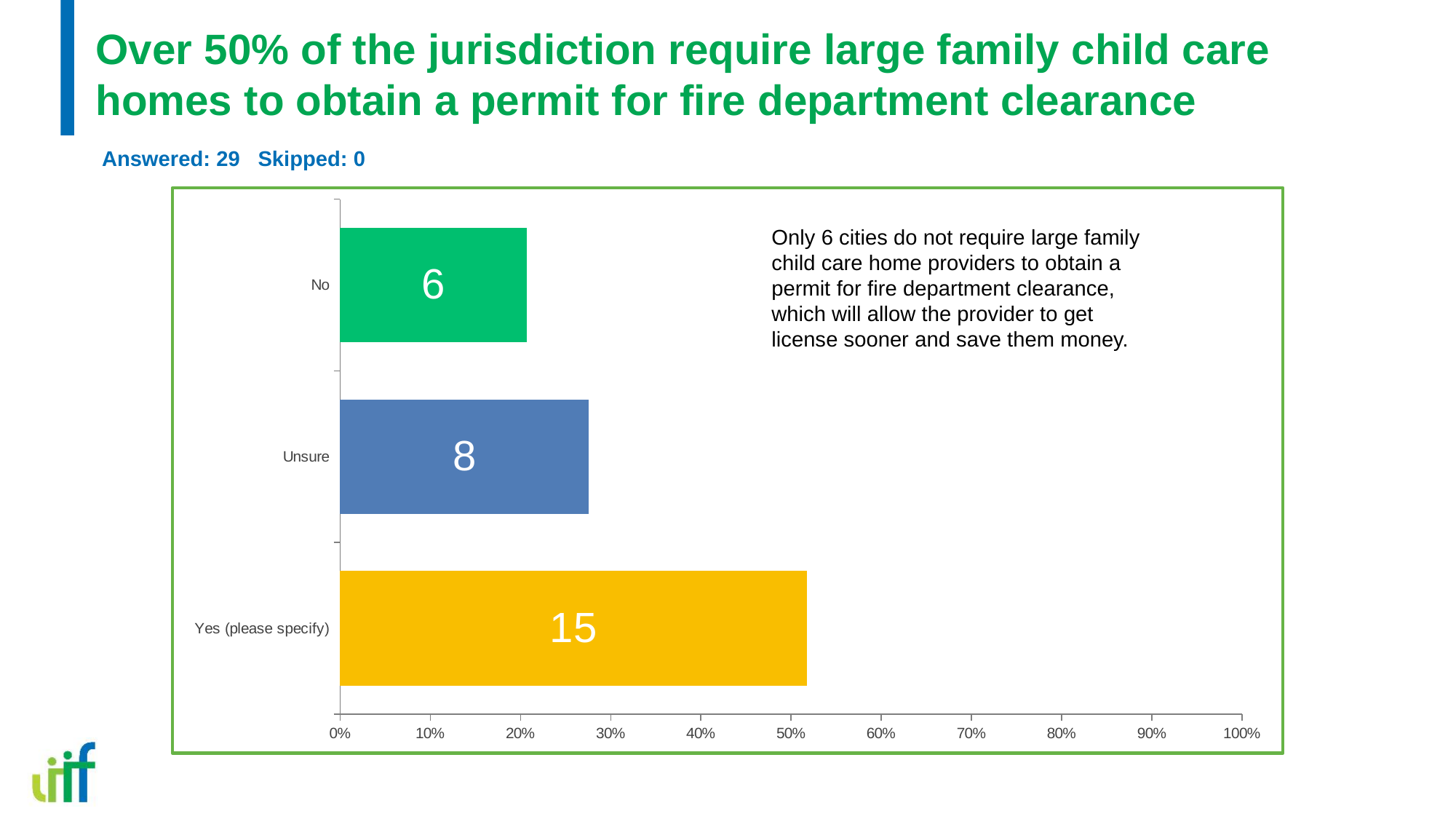
Which has a larger data label, "Unsure" or "No"? Unsure Which category has the longest bar? Yes (please specify) Which category has the shortest bar? No What is the data label on the bar for "Yes (please specify)"? 15 What kind of chart is shown on the slide? bar chart What colour is the bar for "Yes (please specify)"? yellow What is the data label on the bar for "Unsure"? 8 How many categories are shown in the chart? 3 What is the data label on the bar for "No"? 6 What is the difference between the data labels for "Yes (please specify)" and "Unsure"? 7 Is the bar for "Yes (please specify)" greater or less than 50% on the axis? greater Is the bar for "Unsure" greater or less than 30% on the axis? less